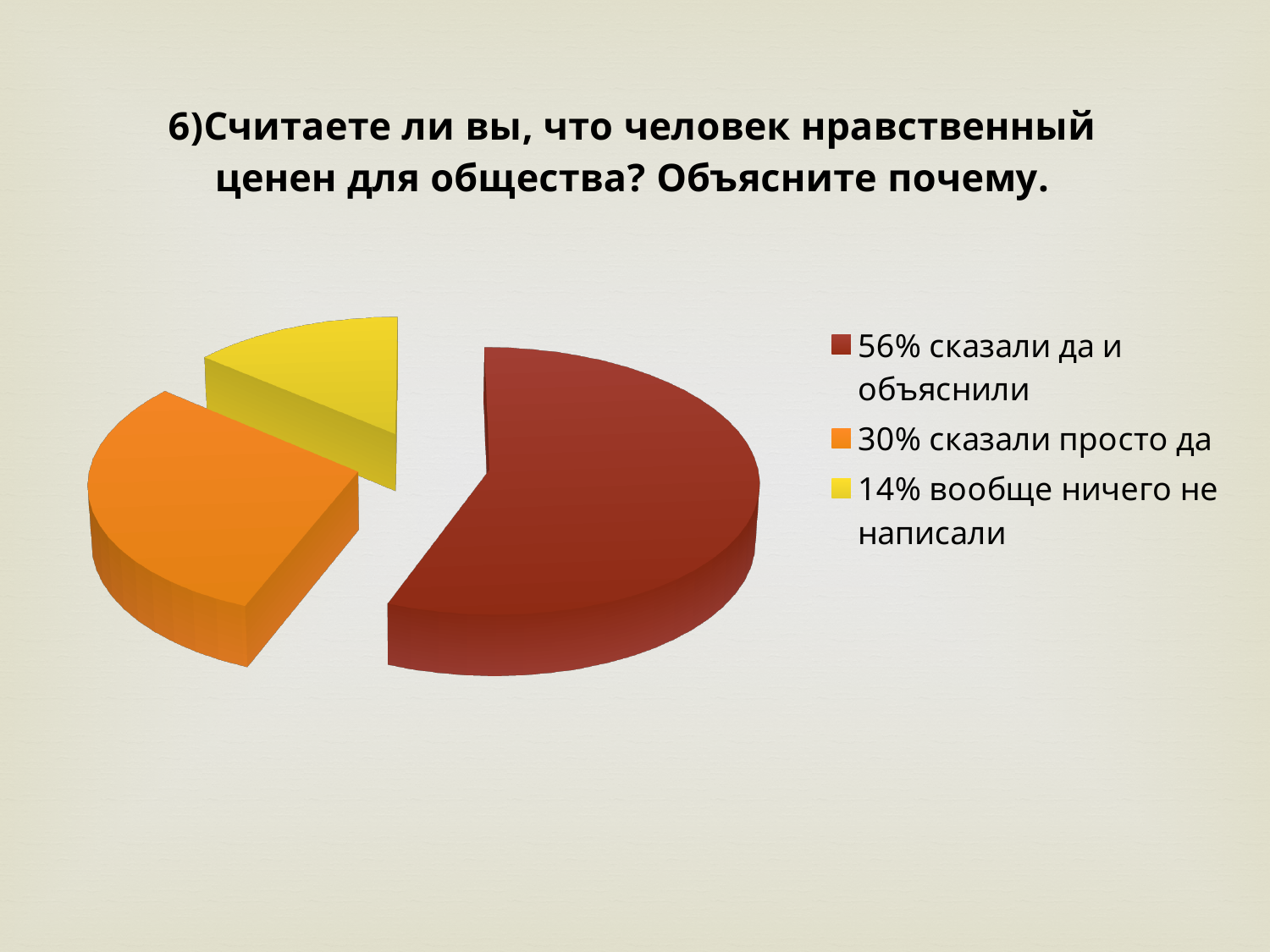
What share of respondents wrote nothing at all ("вообще ничего не написали")? 14% How many entries does the legend list? 3 What share of respondents said yes and explained why ("сказали да и объяснили")? 56% What share of respondents simply said yes ("сказали просто да")? 30% What colour is the largest slice of the pie? dark red Which response category has the smallest slice of the pie? 14% вообще ничего не написали What is the difference in percentage points between those who said yes and explained and those who simply said yes? 26 Which is larger: the share who simply said yes or the share who wrote nothing? 30% сказали просто да What kind of chart is shown on the slide? pie chart How many slices does the pie chart have? 3 What colour is the slice for respondents who wrote nothing at all? yellow Which response category has the largest slice of the pie? 56% сказали да и объяснили